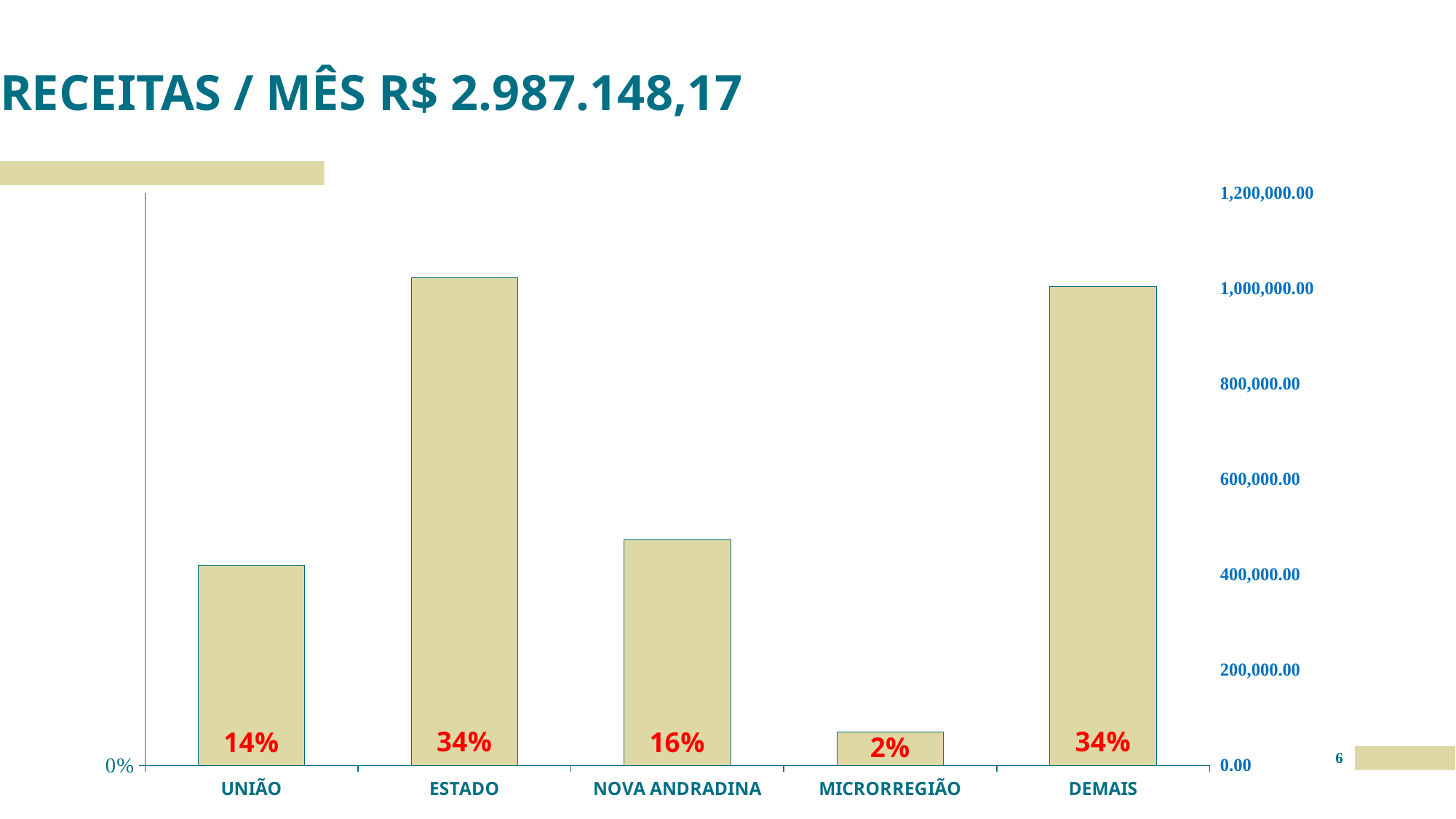
What percentage label is shown on the MICRORREGIÃO bar? 2% How many categories are shown on the x axis? 5 What percentage label is shown on the UNIÃO bar? 14% Which has the larger percentage label, NOVA ANDRADINA or UNIÃO? NOVA ANDRADINA Is the value for NOVA ANDRADINA greater or less than 600,000.00 on the right axis? less Which category has the lowest value? MICRORREGIÃO What is the title of the slide? RECEITAS / MÊS R$ 2.987.148,17 What kind of chart is shown on the slide? bar chart Is the value for ESTADO greater or less than 800,000.00 on the right axis? greater What is the difference in percentage points between the ESTADO and UNIÃO labels? 20 percentage points What percentage label is shown on the NOVA ANDRADINA bar? 16% What percentage label is shown on the ESTADO bar? 34%